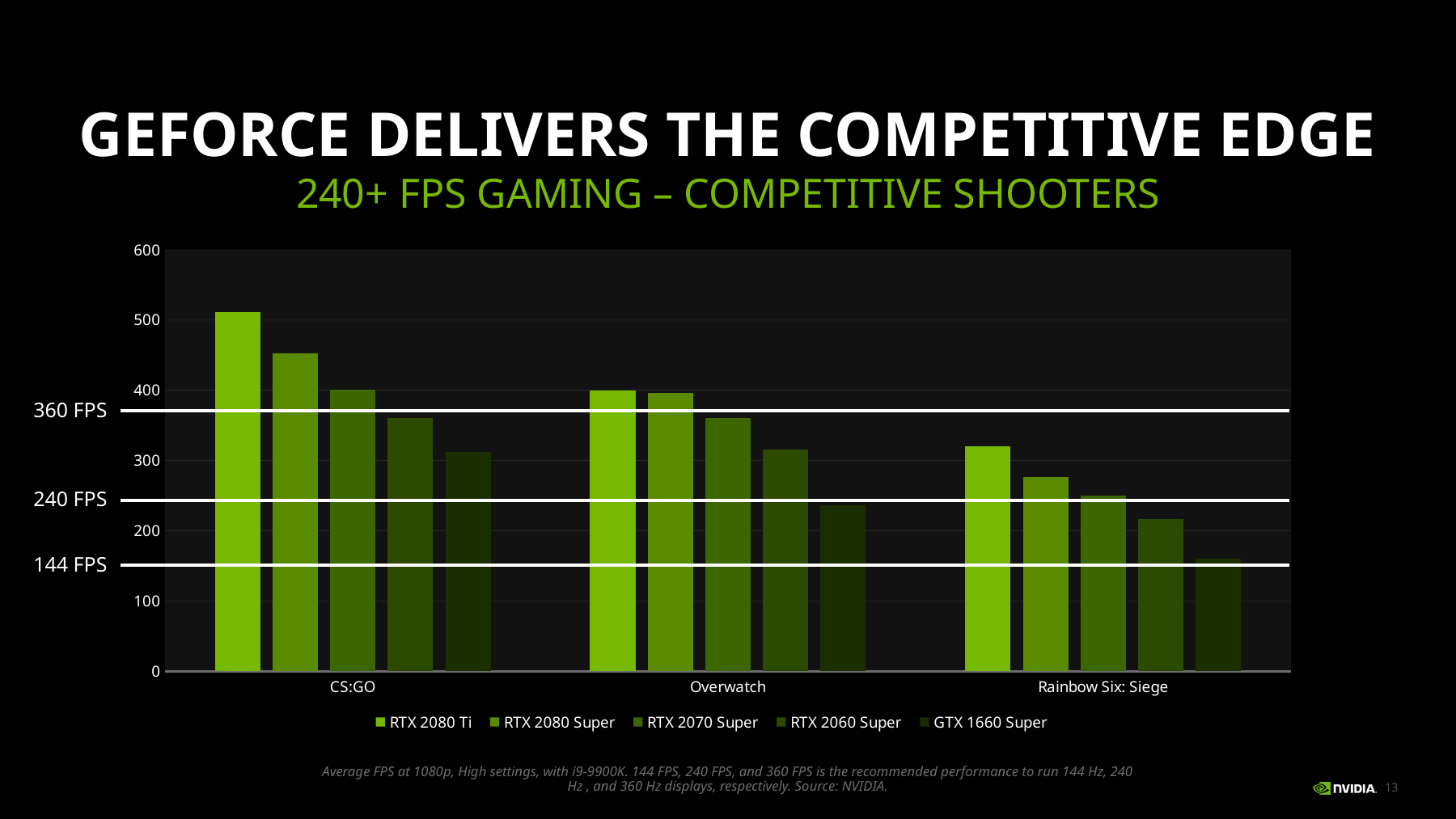
Is the value for GTX 1660 Super in Rainbow Six: Siege greater or less than 200? less How many series does the legend list? 5 What kind of chart is shown on the slide? bar chart How many games are shown on the x axis? 3 Which GPU has the highest value for CS:GO? RTX 2080 Ti What are the three horizontal reference lines on the chart labelled? 144 FPS, 240 FPS, 360 FPS Which GPU has the lowest value for Rainbow Six: Siege? GTX 1660 Super Is the value for GTX 1660 Super in Overwatch greater or less than 300? less Is the value for RTX 2080 Ti in Rainbow Six: Siege greater or less than 300? greater Which is larger: the RTX 2080 Ti value for CS:GO or the RTX 2080 Ti value for Overwatch? CS:GO Do the RTX 2080 Ti values rise or fall moving from CS:GO to Overwatch to Rainbow Six: Siege? fall